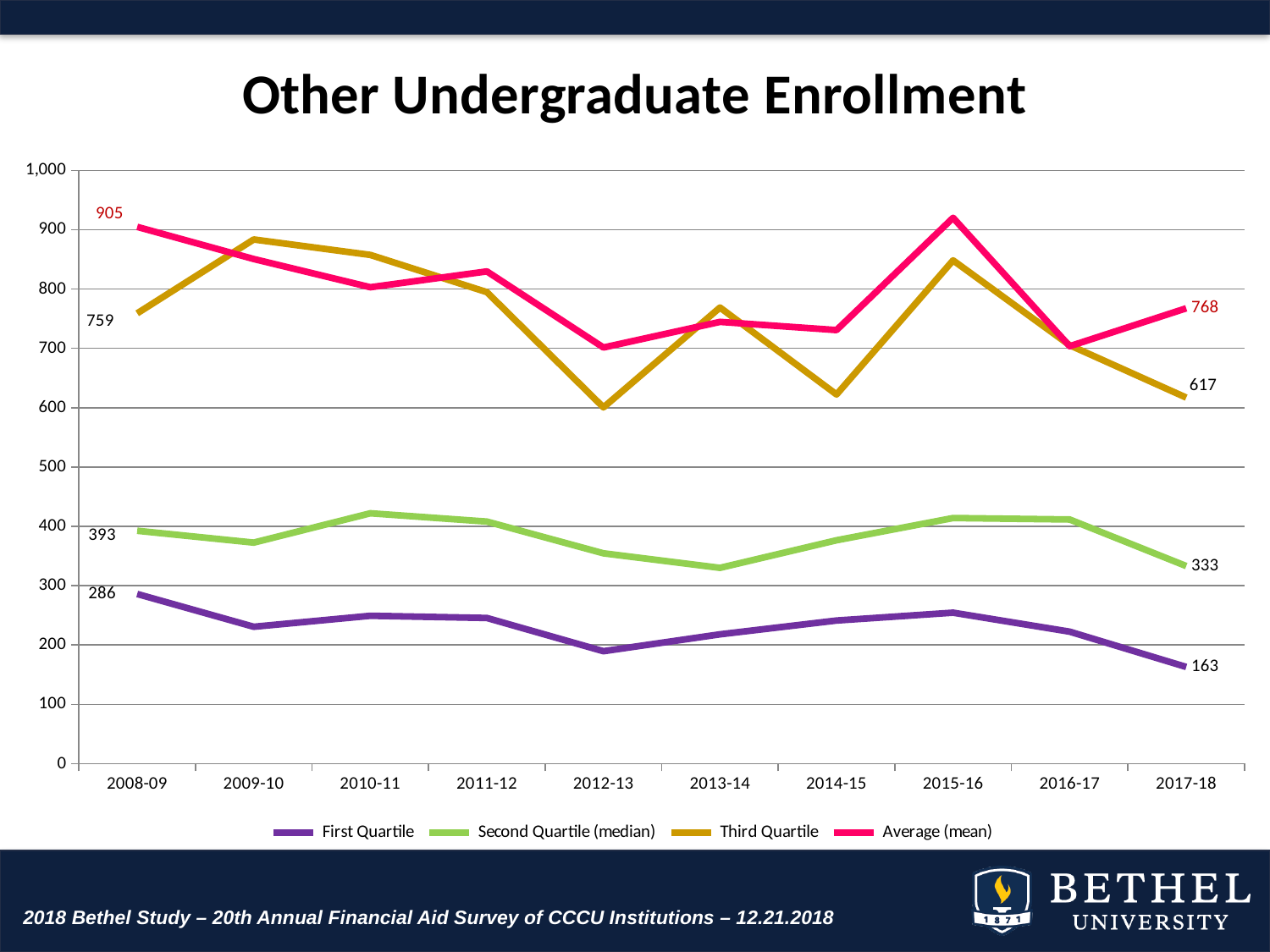
What is the First Quartile value for 2008-09? 286 What kind of chart is shown on the slide? Line chart How many academic years are shown on the x axis? 10 What is the difference between the First Quartile values for 2008-09 and 2017-18? 123 Is the Average (mean) value for 2015-16 greater or less than 900? greater What is the difference between the Average (mean) values for 2008-09 and 2017-18? 137 What is the Second Quartile (median) value for 2017-18? 333 How many series does the legend list? 4 What is the Average (mean) value for 2008-09? 905 What is the Third Quartile value for 2017-18? 617 Is the Third Quartile value for 2012-13 greater or less than 700? less Which is larger, the Third Quartile value for 2008-09 or the Third Quartile value for 2017-18? 2008-09